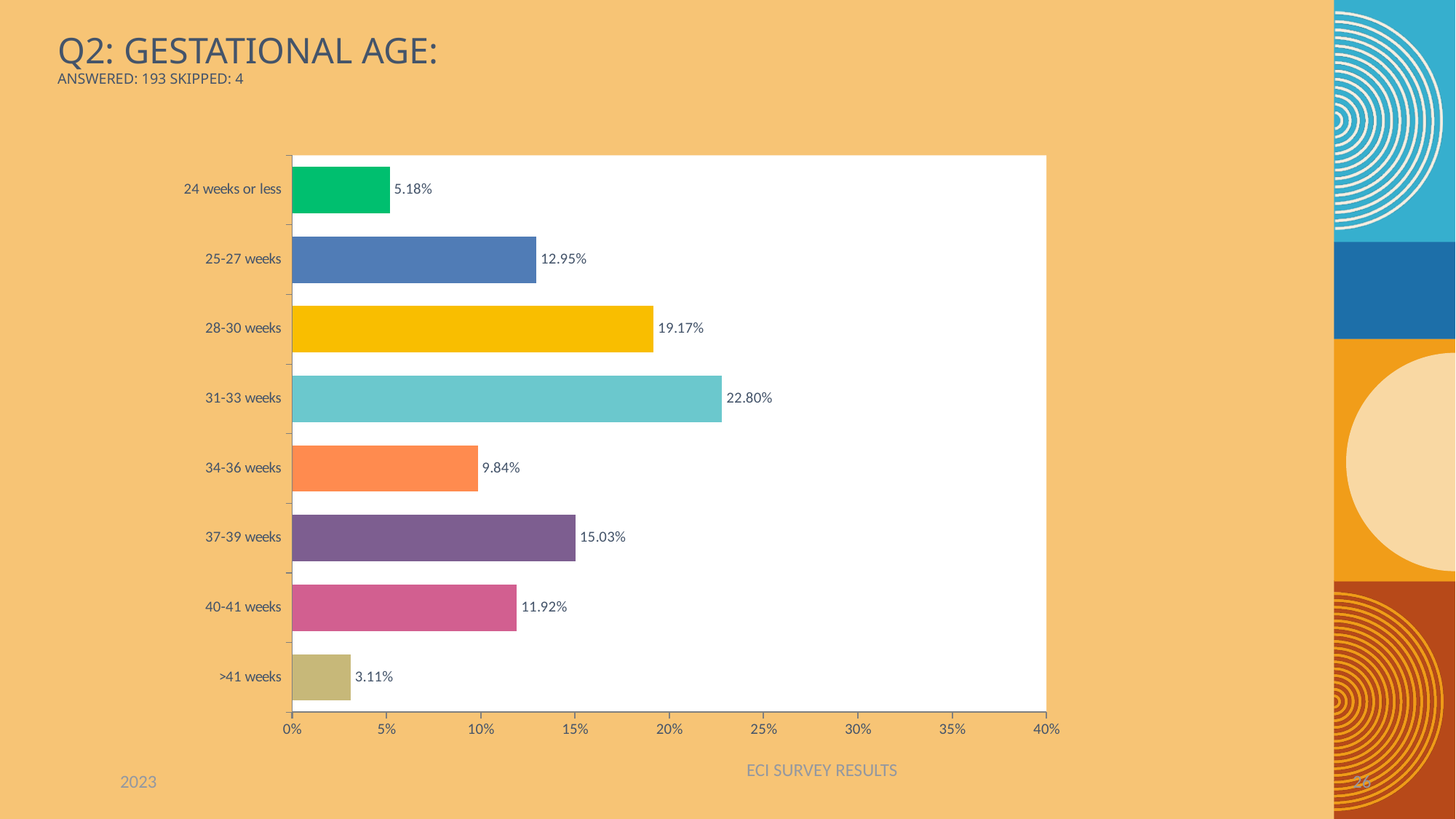
What is the maximum value shown on the horizontal axis? 40% Is the value for 31-33 weeks greater or less than 20%? greater Which gestational age category has the lowest value? >41 weeks What is the value for 37-39 weeks? 15.03% Which gestational age category has the highest value? 31-33 weeks What is the difference between the values for 28-30 weeks and 34-36 weeks? 9.33% Which is larger, the value for 25-27 weeks or the value for 40-41 weeks? 25-27 weeks What is the value for 31-33 weeks? 22.80% What is the difference between the values for 40-41 weeks and >41 weeks? 8.81% What is the value for 24 weeks or less? 5.18% How many gestational age categories are shown in the chart? 8 What kind of chart is shown on the slide? bar chart